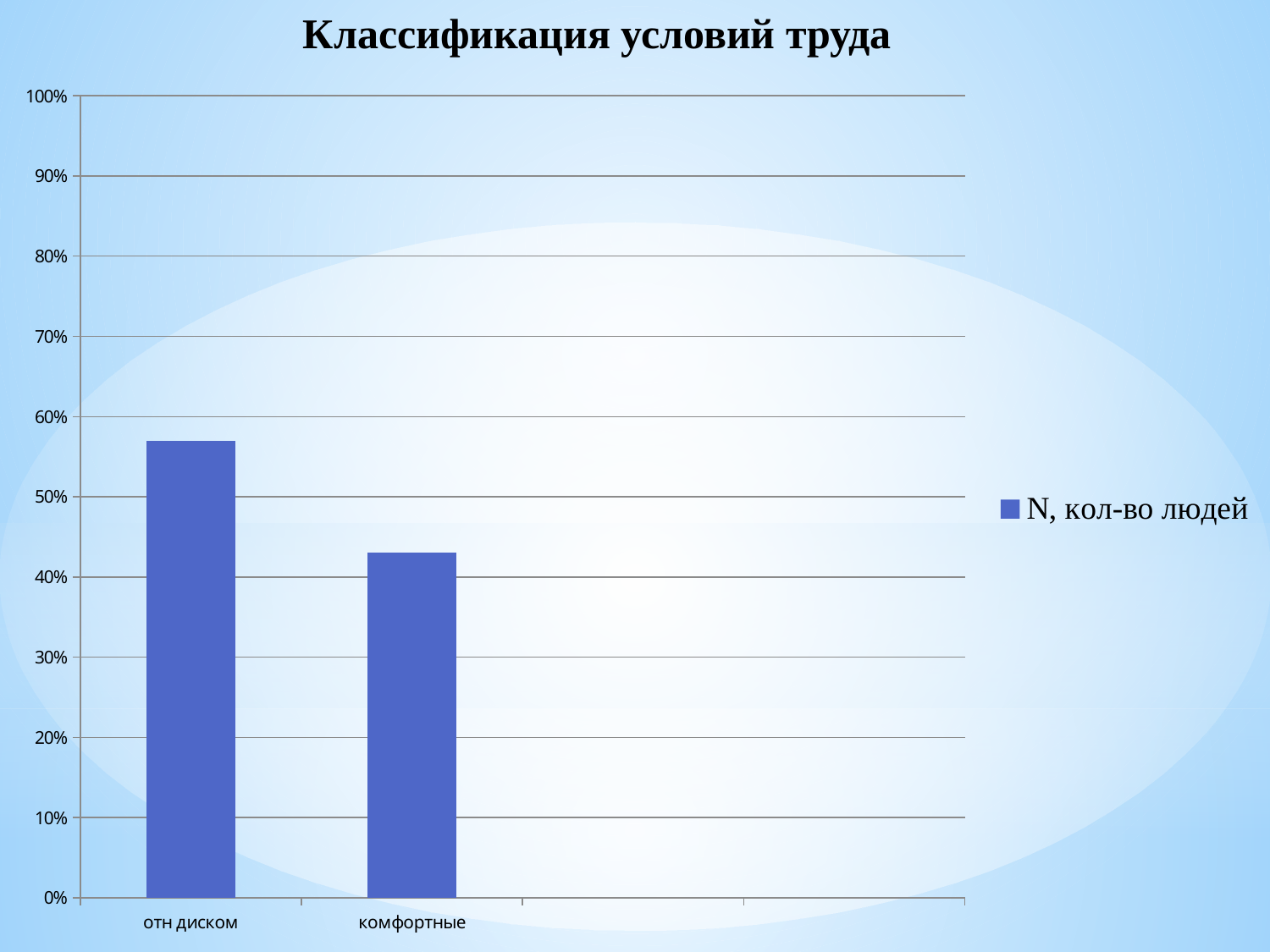
Is the value for комфортные greater or less than 50%? less Which is larger, the value for отн диском or the value for комфортные? отн диском Is the value for отн диском greater or less than 60%? less What is the title of the chart? Классификация условий труда How many categories are plotted on the x axis? 2 Is the value for отн диском greater or less than 50%? greater What kind of chart is shown on the slide? bar chart Which category has the highest bar? отн диском Which category has the lowest bar? комфортные How many series does the legend list? 1 What series name is shown in the legend? N, кол-во людей